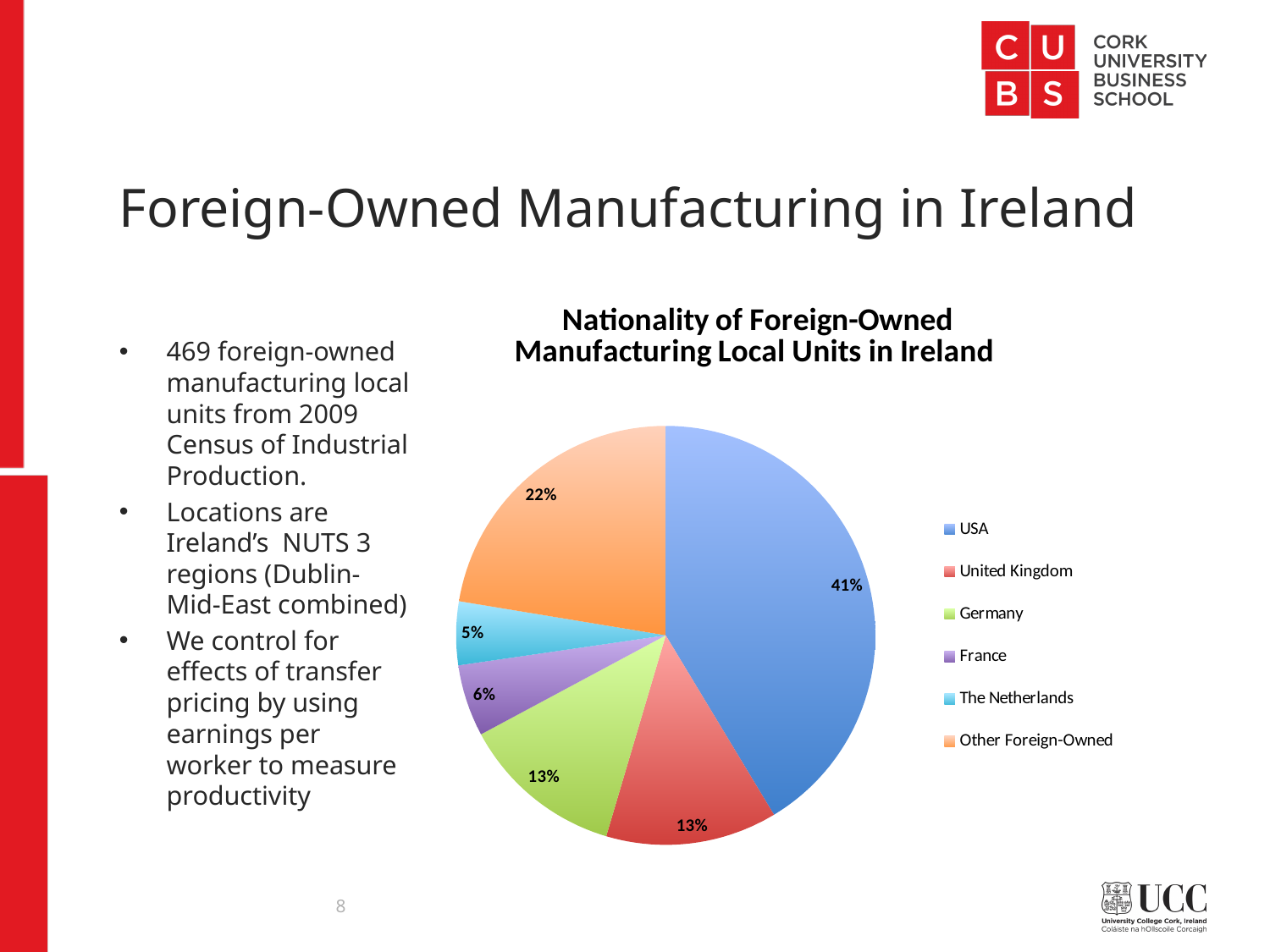
What share of the pie does USA hold? 41% Which nationality has the smallest share of the pie? The Netherlands Which nationality has the largest share of the pie? USA Which has a larger share, France or The Netherlands? France What kind of chart is shown on the slide? Pie chart What percentage is shown for The Netherlands? 5% What percentage is shown for Other Foreign-Owned? 22% What percentage is shown for France? 6% What percentage is shown for Germany? 13% What is the title of the chart? Nationality of Foreign-Owned Manufacturing Local Units in Ireland How many categories does the legend list? 6 What is the difference in percentage points between USA and Other Foreign-Owned? 19